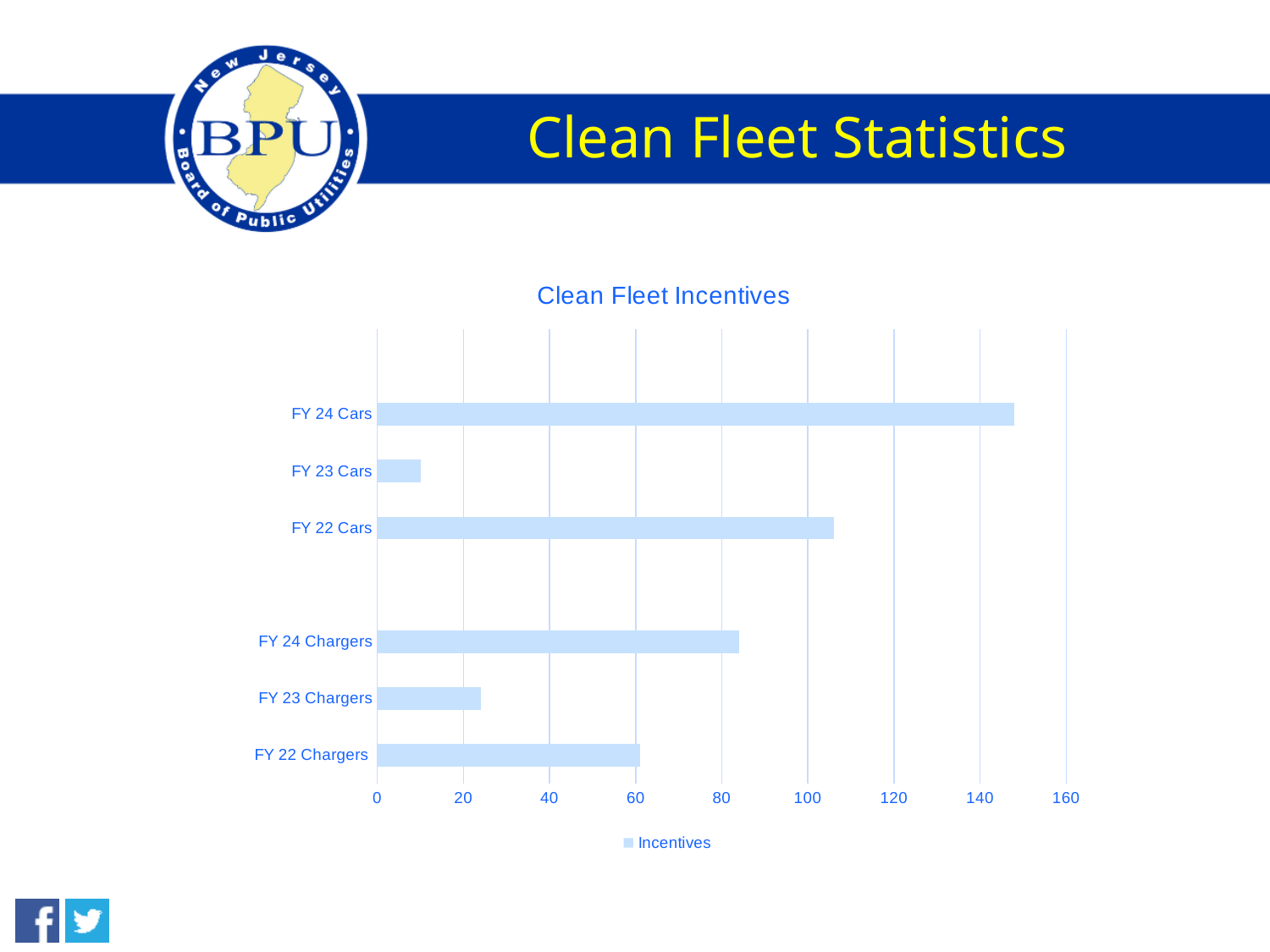
Is the value for FY 24 Chargers greater or less than 80? greater Which category has the highest value? FY 24 Cars Is the value for FY 24 Cars greater or less than 140? greater Which category has the lowest value? FY 23 Cars Which is larger, the value for FY 22 Cars or the value for FY 24 Chargers? FY 22 Cars What kind of chart is shown on the slide? bar chart How many series does the legend list? 1 What is the name of the series shown in the legend? Incentives What is the title of the chart? Clean Fleet Incentives Is the value for FY 23 Cars greater or less than 20? less How many categories are plotted in the chart? 6 Which is larger, the value for FY 23 Chargers or the value for FY 22 Chargers? FY 22 Chargers